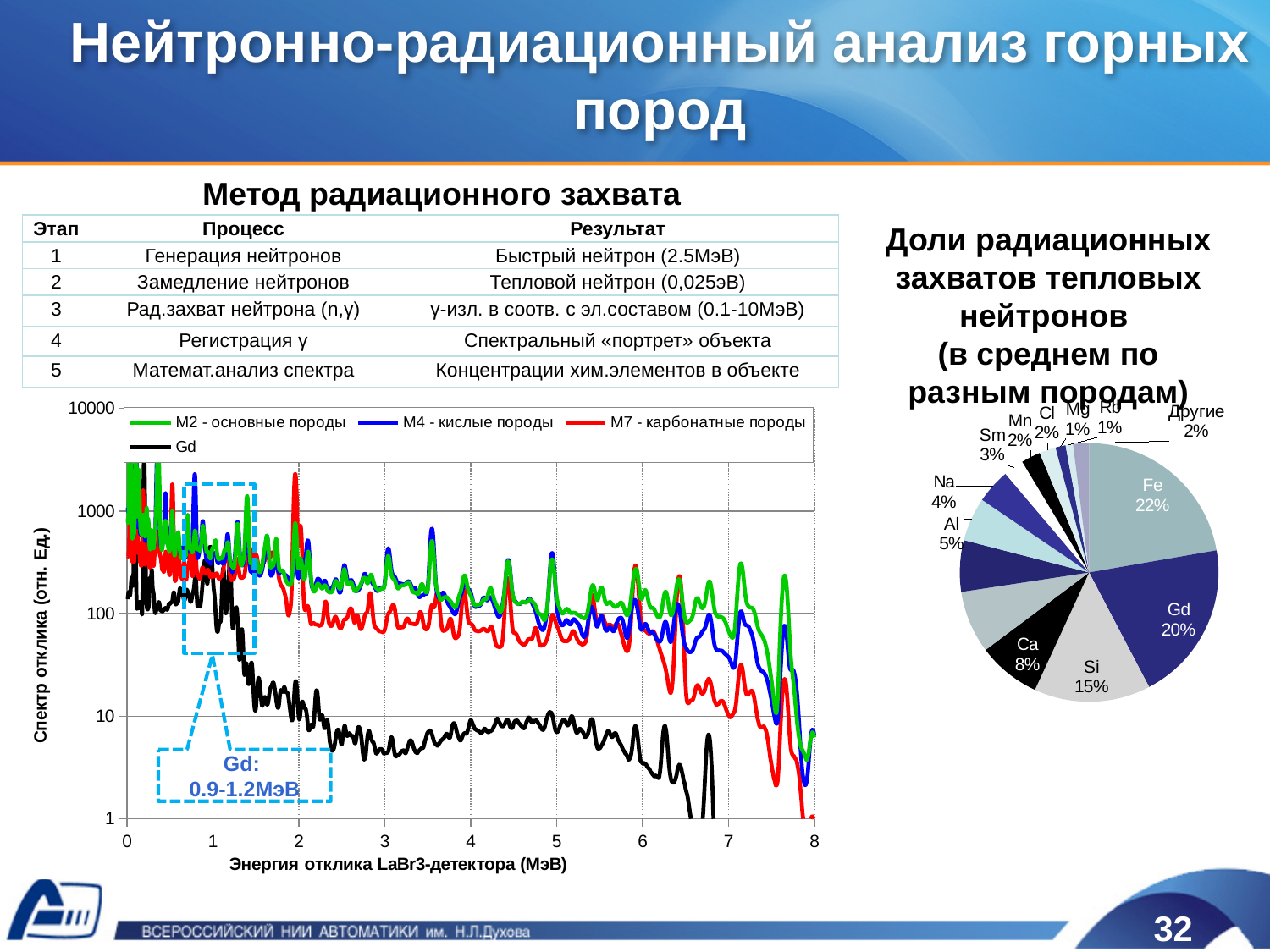
In the pie chart on the right, which has the larger share, Si or Ca? Si What kind of chart is the chart on the left with the energy axis? Line chart In the line chart on the left, does the Gd series overall rise or fall as energy increases along the x axis? Fall How many series does the legend of the line chart on the left list? 4 In the pie chart on the right, what share does Ca have? 8% In the pie chart on the right, what is the difference between the shares of Fe and Gd? 2% In the pie chart on the right, which element has the largest share? Fe In the pie chart on the right, what share does Gd have? 20% In the pie chart on the right, what is the combined share of Fe, Gd and Si? 57% In the pie chart on the right, what share does Fe have? 22% In the line chart on the left, what colour is the series 'M7 - карбонатные породы'? Red